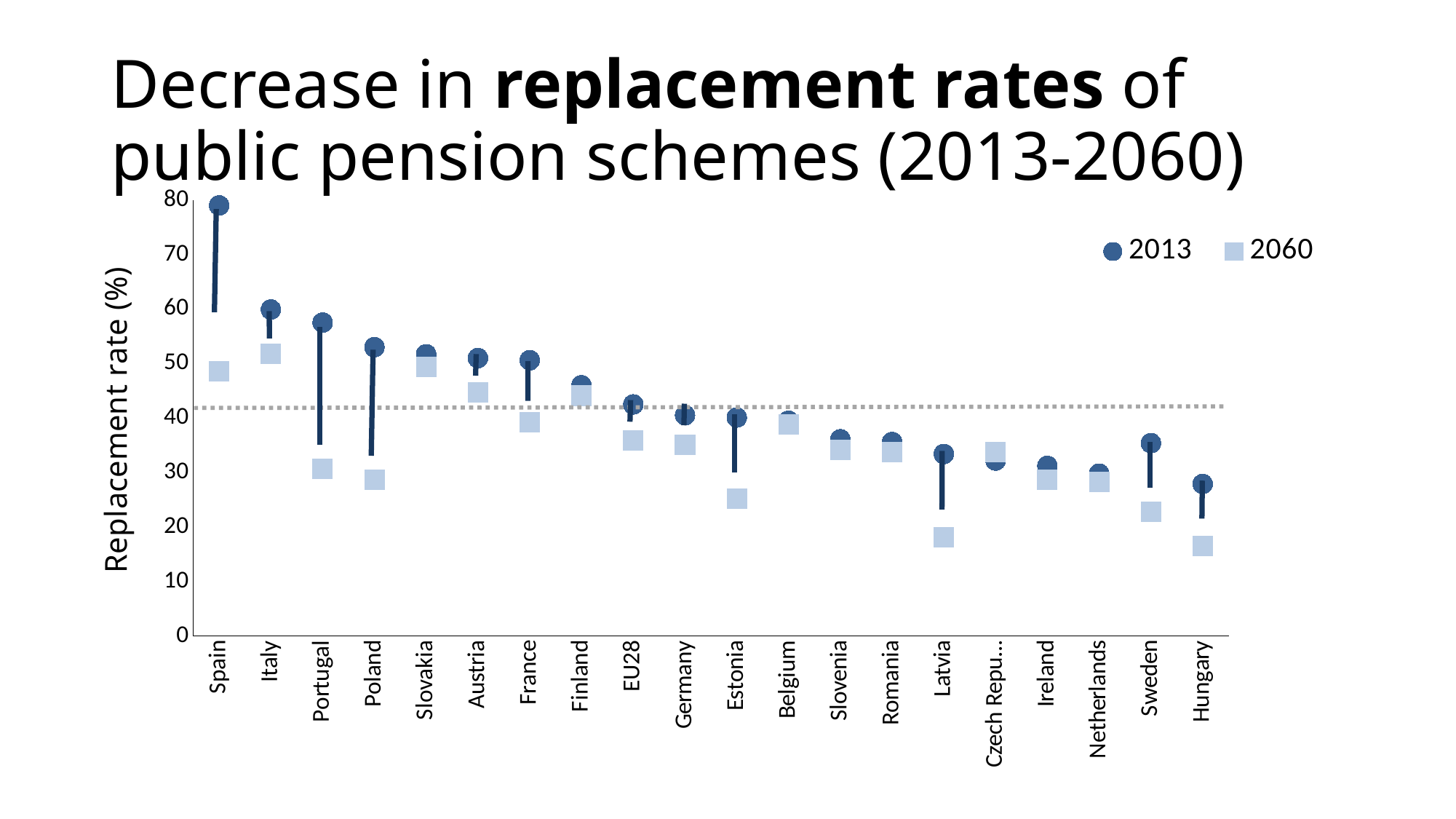
Which country has the lowest 2060 replacement rate? Hungary Do the 2013 values generally rise or fall moving from left to right along the x axis? fall Is the 2013 value for Spain greater or less than 70? greater How many series does the legend list? 2 What kind of chart is shown on the slide? Scatter (dot) chart Which is larger: the 2060 value for Slovakia or the 2060 value for Portugal? Slovakia What is the label of the y axis? Replacement rate (%) Which country has the lowest 2013 replacement rate? Hungary Is the 2060 value for Estonia greater or less than 30? less Is the 2060 value for Portugal greater or less than 40? less Which country has the highest 2013 replacement rate? Spain How many countries/regions are shown on the x axis? 20